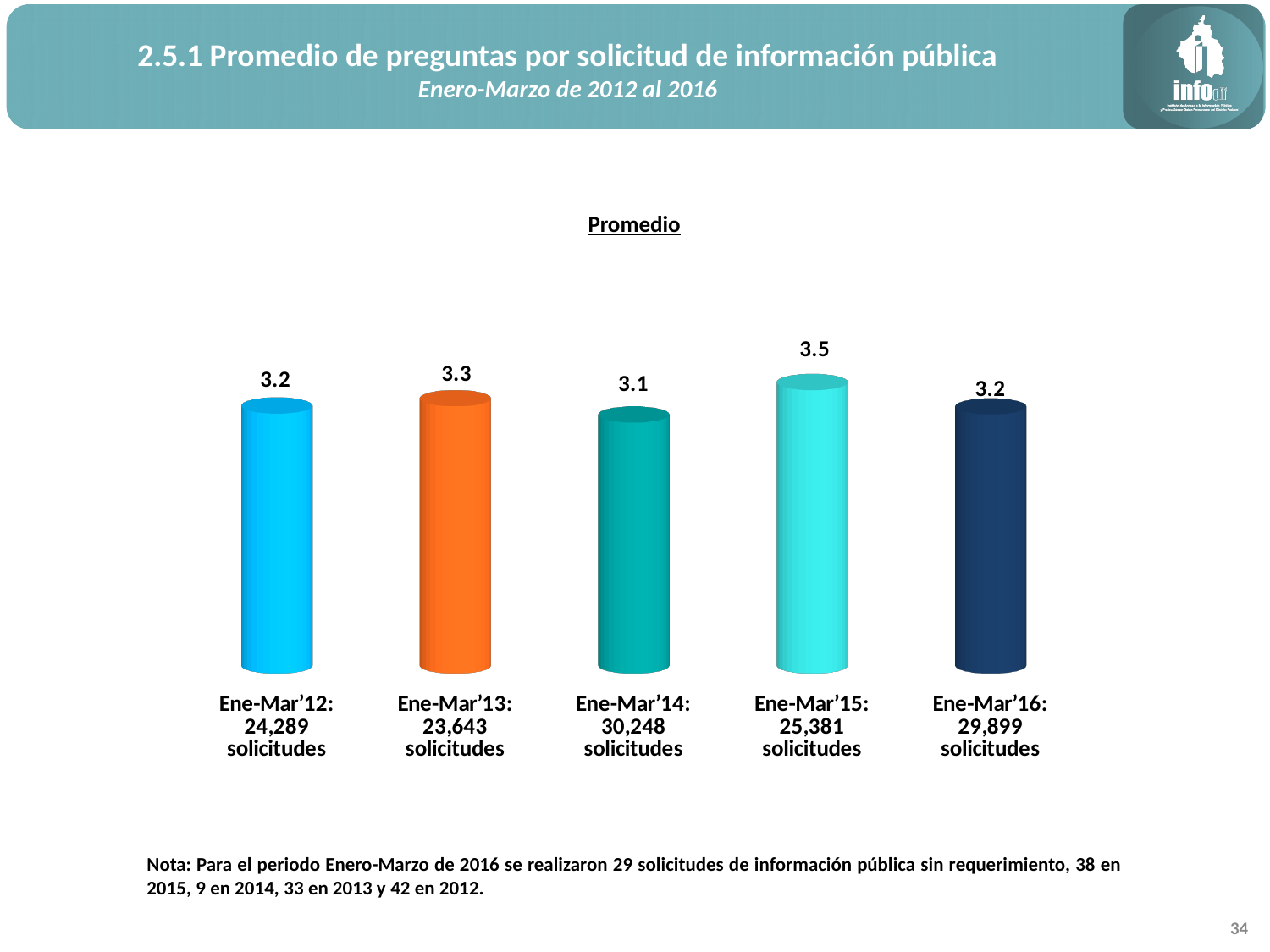
Which period has the lowest average? Ene-Mar'14 What is the value shown for Ene-Mar'15? 3.5 What is the value shown for Ene-Mar'14? 3.1 What is the difference between the values for Ene-Mar'15 and Ene-Mar'14? 0.4 How many periods are plotted in the chart? 5 What is the average number of questions per request for Ene-Mar'12? 3.2 How many solicitudes are listed under the Ene-Mar'14 label? 30,248 What colour is the bar for Ene-Mar'13? Orange What is the label shown above the chart? Promedio Which period has the highest average? Ene-Mar'15 Which is larger, the value for Ene-Mar'13 or the value for Ene-Mar'16? Ene-Mar'13 What kind of chart is shown on the slide? Bar chart